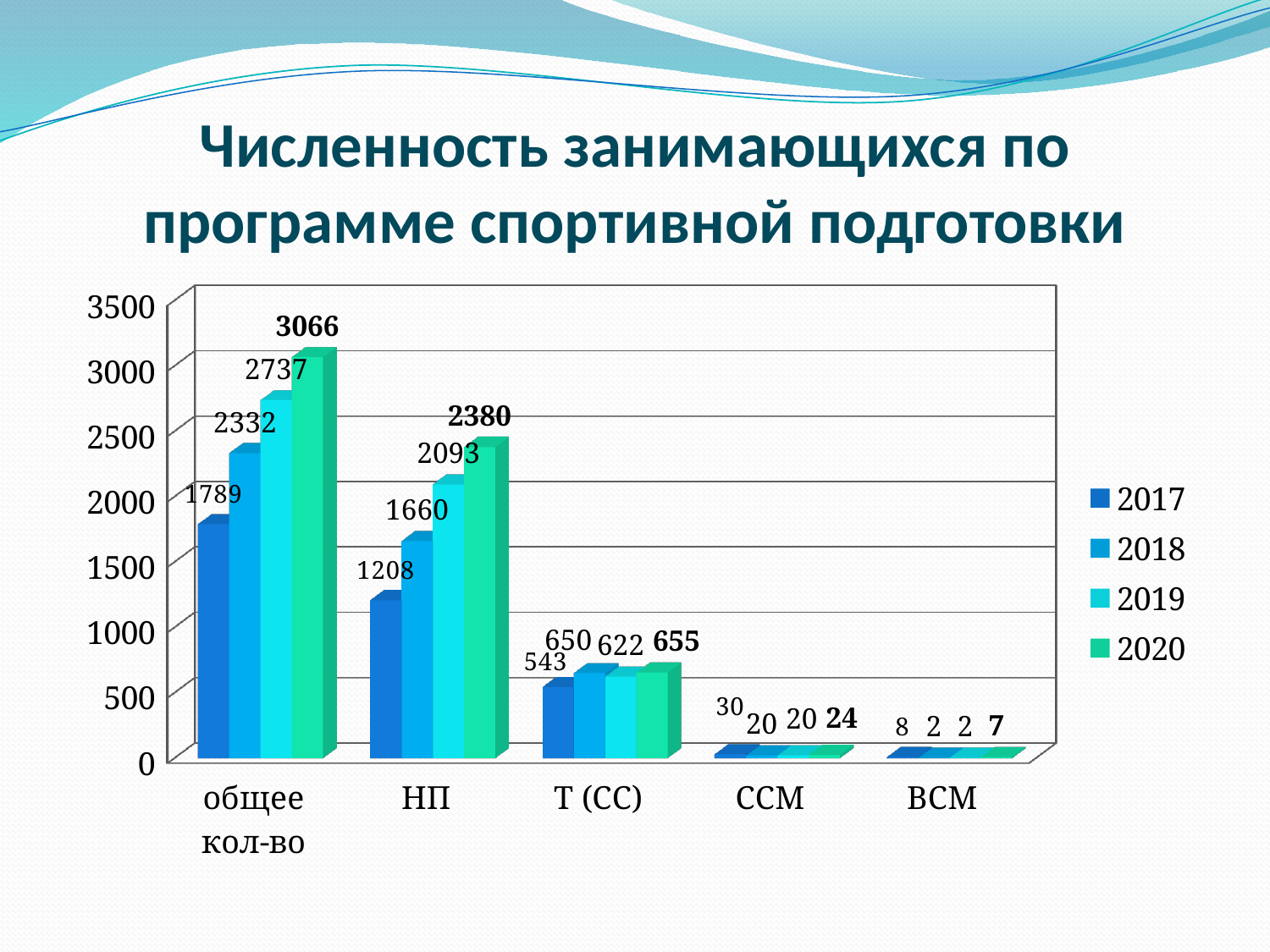
What is the value for 2017 in the НП category? 1208 Which is larger in the Т (СС) category: the 2018 value or the 2019 value? 2018 What is the value for 2018 in the ССМ category? 20 What is the difference between the 2020 and 2019 values in the НП category? 287 What kind of chart is shown on the slide? Bar chart What is the value for 2020 in the общее кол-во category? 3066 What is the difference between the 2020 and 2017 values in the общее кол-во category? 1277 How many series does the legend list? 4 Which year has the lowest value in the ВСМ category? 2018 and 2019 (both 2) How many categories are shown on the x axis? 5 Which year has the highest value in the общее кол-во category? 2020 What is the value for 2019 in the Т (СС) category? 622